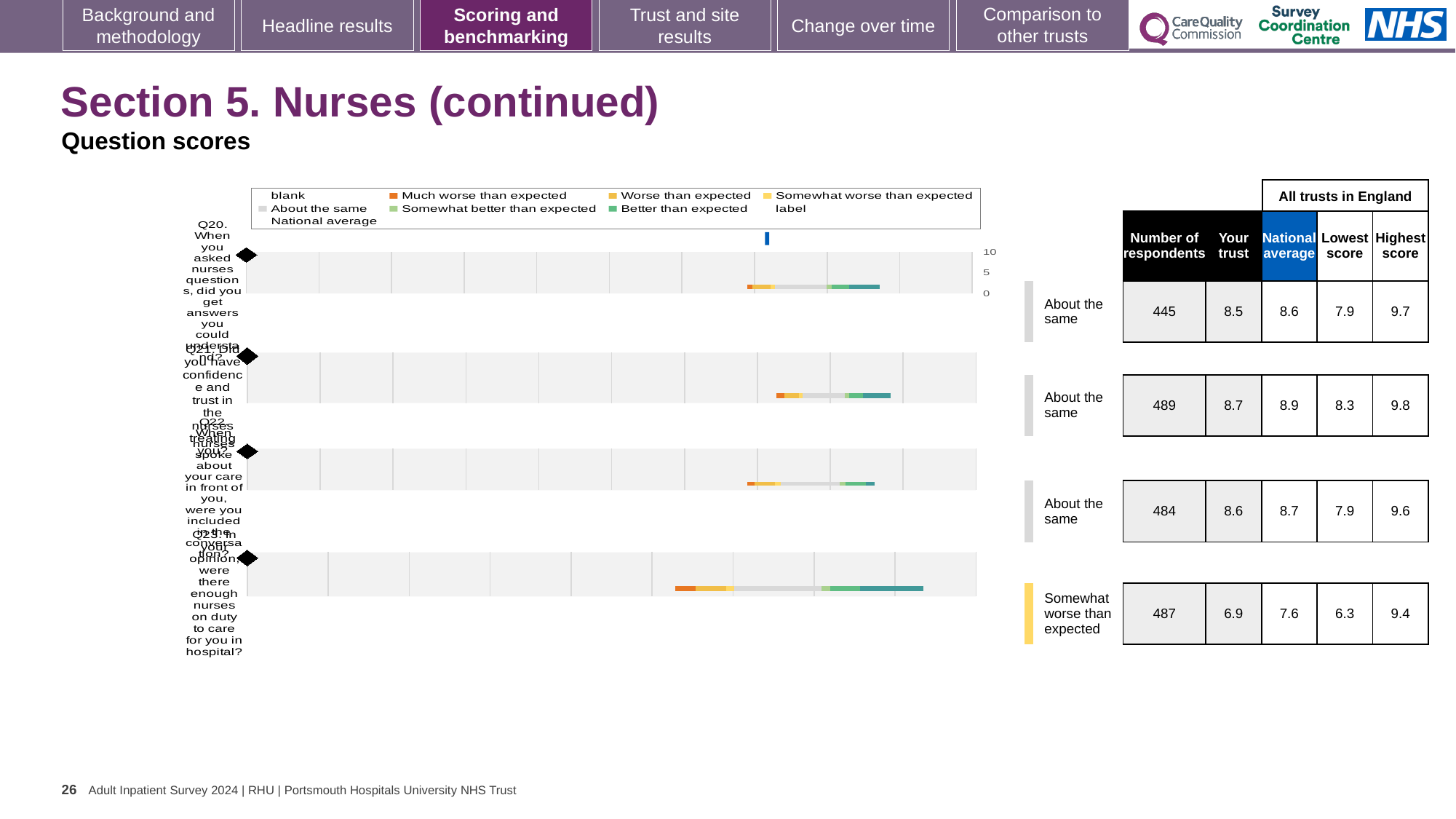
How many respondents answered Q20? 445 What is the highest value shown on the chart's score axis? 10 How many questions (bars) are plotted in the chart? 4 Is the 'Your trust' value for Q23 greater or less than 5? greater For Q20, which is larger: the 'Your trust' score or the national average? National average Which colour in the legend represents 'Much worse than expected'? Orange What is the 'Your trust' score for Q23 (were there enough nurses on duty)? 6.9 What is the difference between the 'Your trust' scores for Q21 and Q23? 1.8 Which question has the highest 'Your trust' score? Q21 Which question has the lowest 'Your trust' score? Q23 What is the national average score for Q21 (confidence and trust in nurses)? 8.9 What kind of chart is shown on the slide? Bar chart